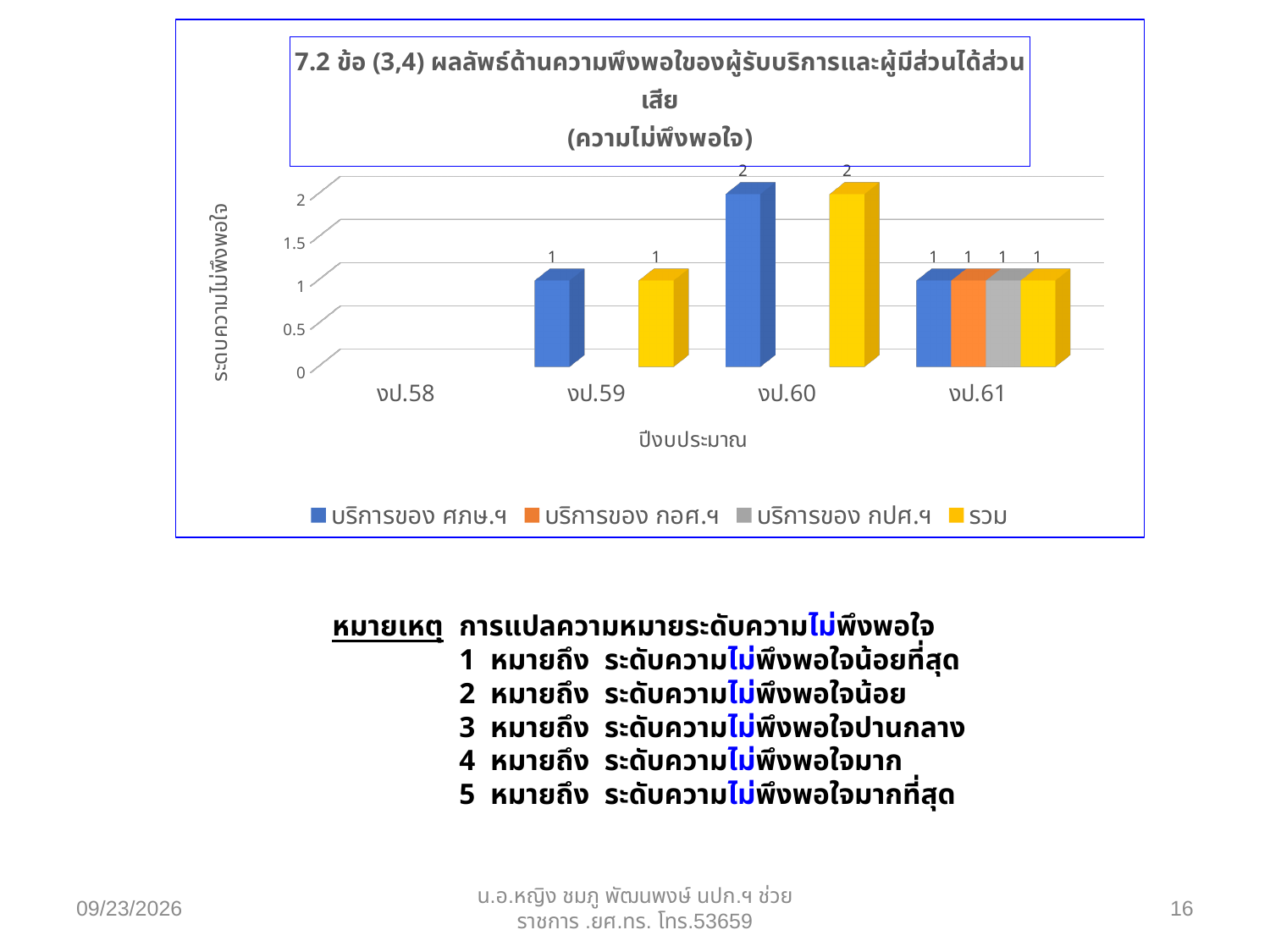
Which colour represents the series รวม in the legend? yellow In which fiscal year does รวม reach its highest value? งป.60 How many fiscal-year categories are shown on the x axis? 4 What is the difference between the รวม value in งป.60 and in งป.61? 1 What is the label of the y axis? ระดับความไม่พึงพอใจ What is the value for บริการของ กอศ.ฯ in งป.61? 1 What is the value for บริการของ กปศ.ฯ in งป.61? 1 What is the value for บริการของ ศภษ.ฯ in งป.60? 2 What is the value for รวม in งป.59? 1 What type of chart is shown on the slide? bar chart How many series does the legend list? 4 Which is larger: บริการของ ศภษ.ฯ in งป.60 or บริการของ ศภษ.ฯ in งป.59? งป.60